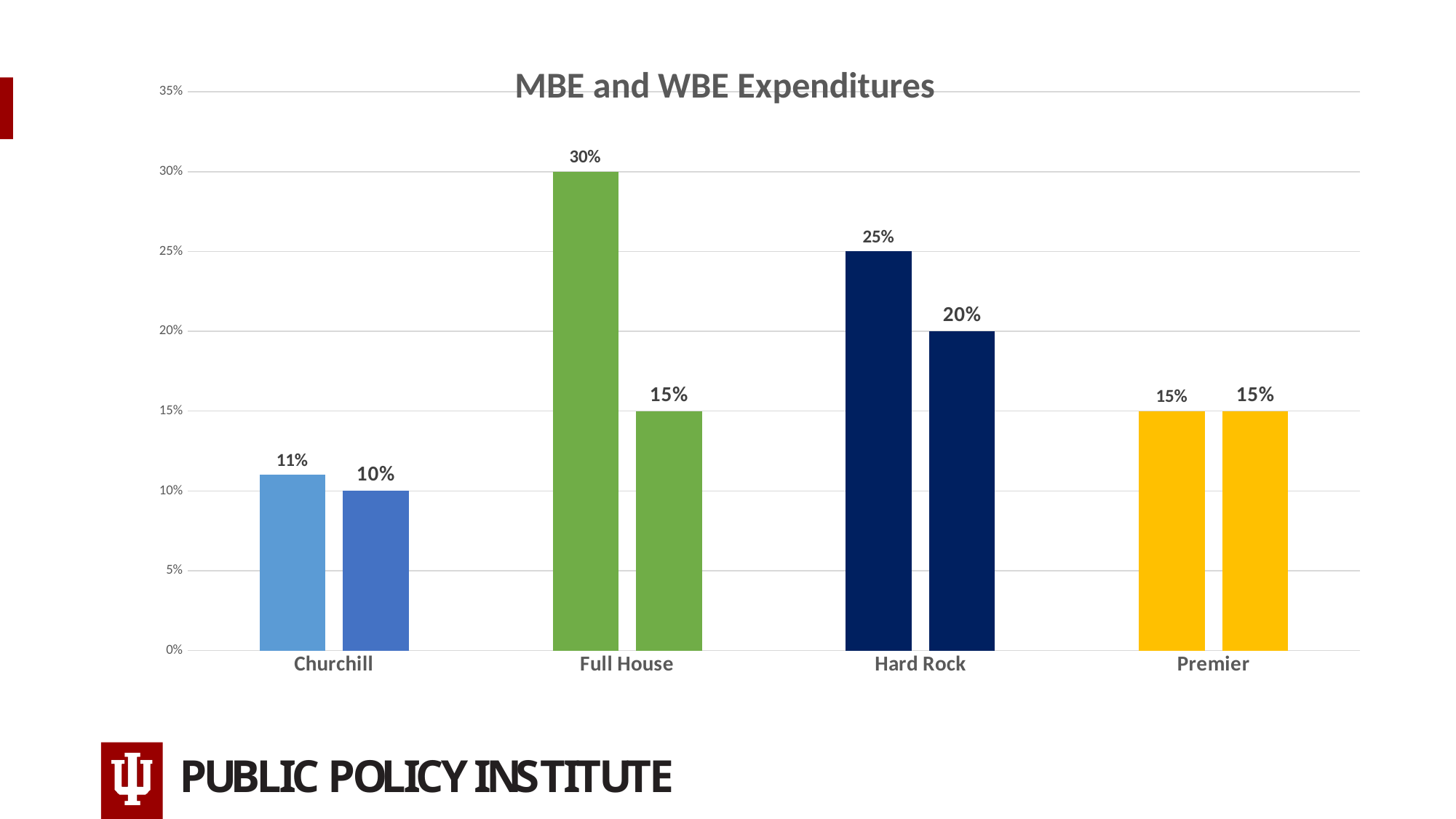
What type of chart is shown on the slide? Bar chart What is the value of the right bar for Premier? 15% How many categories are shown on the x axis? 4 What is the difference between the left bar for Hard Rock and the left bar for Churchill? 14% Which category has the tallest bar in the chart? Full House What is the value of the right bar for Hard Rock? 20% What is the difference between the left and right bars for Full House? 15% What is the title of the chart? MBE and WBE Expenditures What is the value of the left bar for Churchill? 11% What is the value of the left bar for Full House? 30% Which category has the shortest bar in the chart? Churchill Which is larger, the left bar for Hard Rock or the right bar for Full House? Hard Rock left bar (25%)